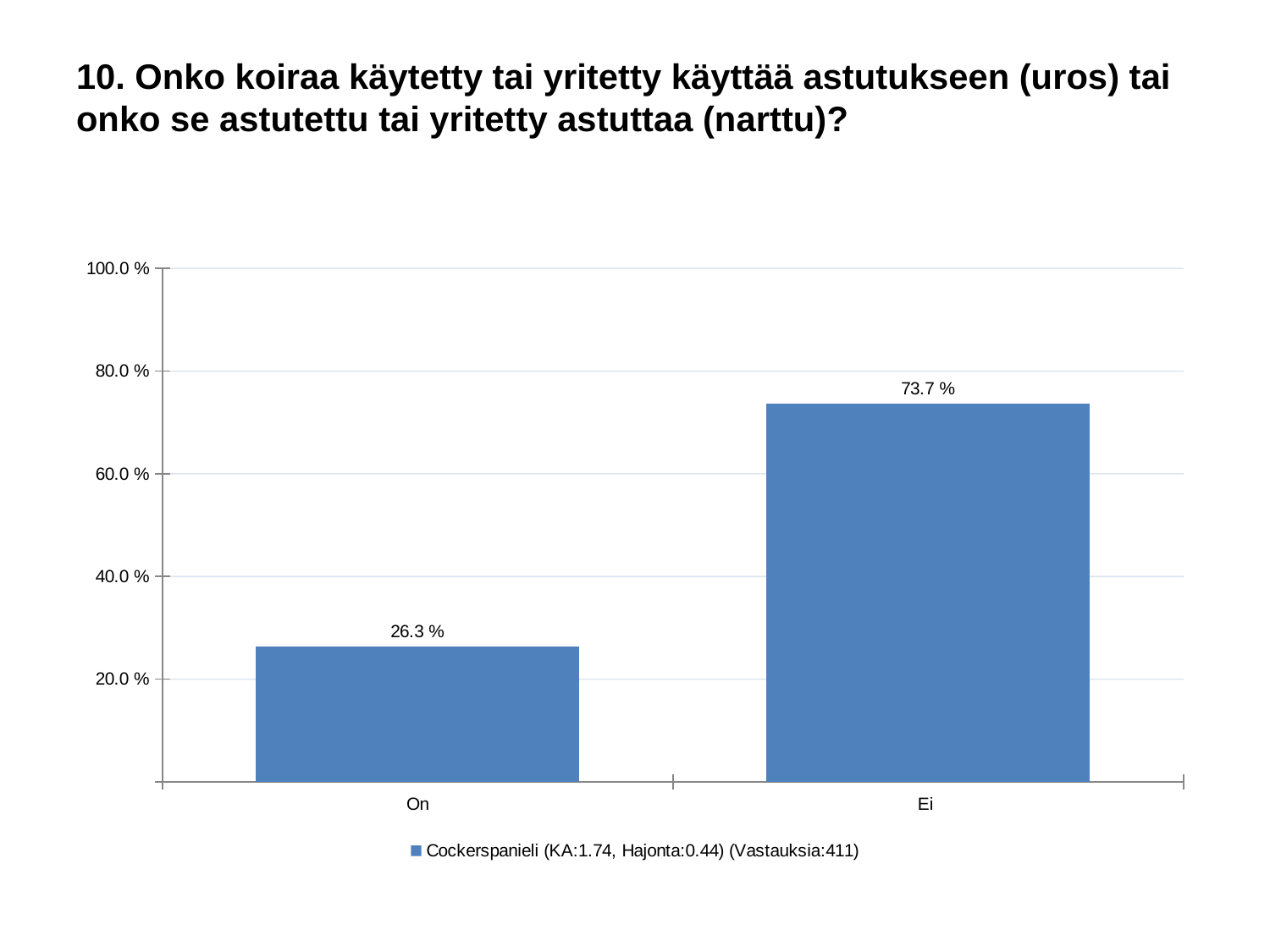
How many categories are shown on the x axis? 2 What is the difference between the values for "Ei" and "On"? 47.4 % Which category has the highest value? Ei Is the value for "On" greater or less than 40.0 %? less What is the value for "On"? 26.3 % What is the value for "Ei"? 73.7 % How many responses (Vastauksia) does the legend entry report? 411 Which is larger, the value for "On" or the value for "Ei"? Ei Which category has the lowest value? On How many series does the legend list? 1 Is the value for "Ei" greater or less than 60.0 %? greater What kind of chart is shown on the slide? bar chart